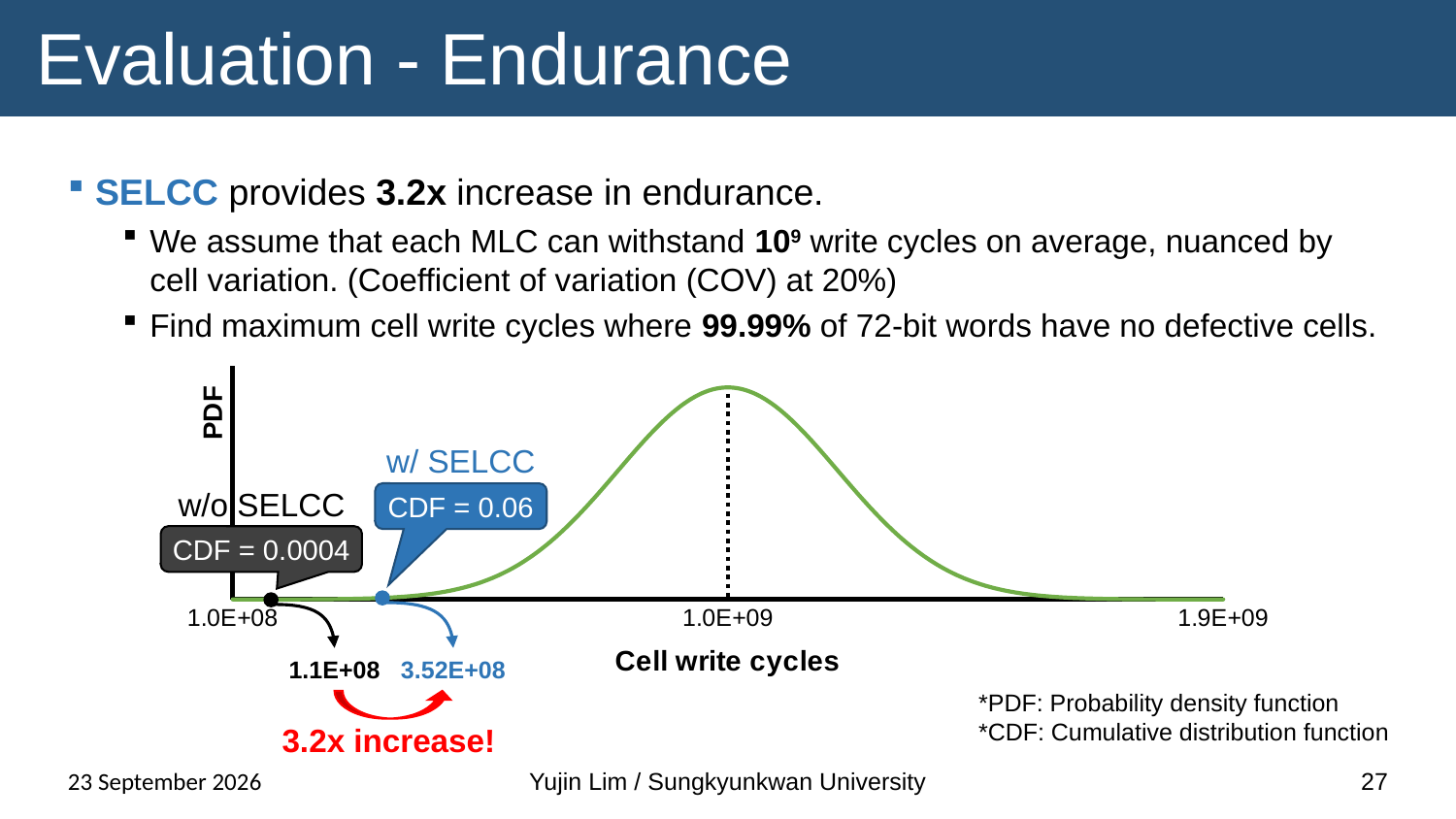
What kind of chart is shown on the slide? line chart Is the cell write cycle value for w/ SELCC greater or less than 1.0E+09? less At what x-axis value does the peak of the PDF curve occur, as marked by the dotted line? 1.0E+09 What is the maximum cell write cycle value marked for w/o SELCC? 1.1E+08 What is the label of the x axis? Cell write cycles Which has the larger cell write cycle value, w/o SELCC or w/ SELCC? w/ SELCC What is the maximum cell write cycle value marked for w/ SELCC? 3.52E+08 What CDF value is shown for w/o SELCC? CDF = 0.0004 How many tick values are printed on the x axis? 3 By what factor does the chart say the cell write cycles increase with SELCC? 3.2x What is the label of the y axis? PDF What CDF value is shown for w/ SELCC? CDF = 0.06